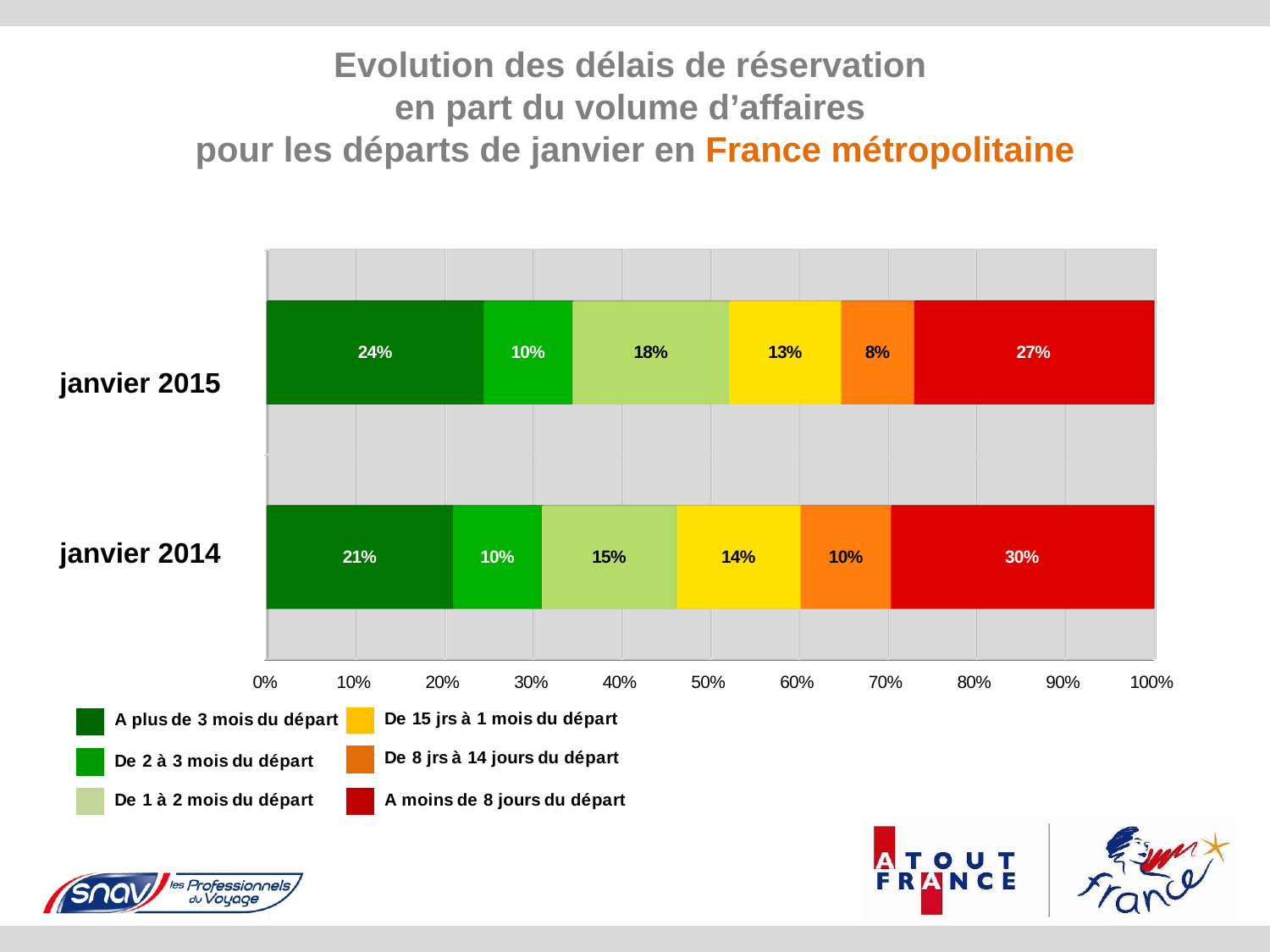
How many series does the legend list? 6 What is the value for "De 1 à 2 mois du départ" in janvier 2014? 15% What is the value for "A plus de 3 mois du départ" in janvier 2015? 24% What is the difference between the "A moins de 8 jours du départ" values for janvier 2014 and janvier 2015? 3% What is the value for "A moins de 8 jours du départ" in janvier 2014? 30% What is the value for "De 8 jrs à 14 jours du départ" in janvier 2015? 8% Which segment is the smallest in the janvier 2015 bar? De 8 jrs à 14 jours du départ Which is larger: "De 15 jrs à 1 mois du départ" in janvier 2015 or in janvier 2014? janvier 2014 How many bars (categories) are plotted on the chart? 2 Which segment is the largest in the janvier 2015 bar? A moins de 8 jours du départ What kind of chart is shown on the slide? Stacked bar chart Which colour represents "A moins de 8 jours du départ" in the legend? Red